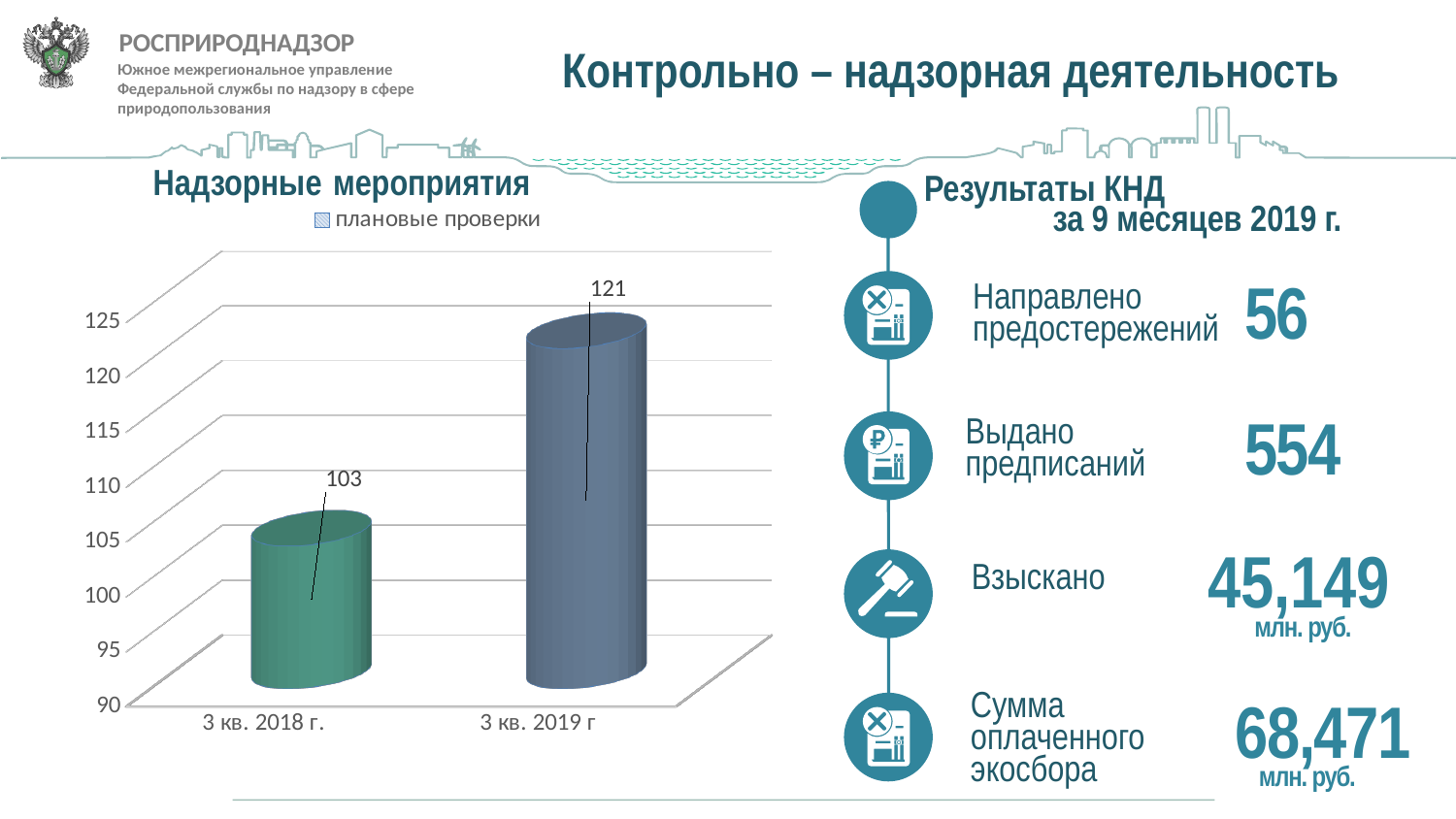
How many series does the chart legend list? 1 Which category has the lowest value in the chart? 3 кв. 2018 г. What is the value for 3 кв. 2019 г in the chart? 121 Which is larger: the value for 3 кв. 2018 г. or the value for 3 кв. 2019 г? 3 кв. 2019 г Is the value for 3 кв. 2018 г. greater or less than 110? less Is the value for 3 кв. 2019 г greater or less than 115? greater Which category has the highest value in the chart? 3 кв. 2019 г How many categories are shown on the x axis of the chart? 2 What kind of chart is shown on the slide? bar chart What is the value for 3 кв. 2018 г. in the chart? 103 What is the name of the series shown in the chart legend? плановые проверки What is the difference between the values for 3 кв. 2019 г and 3 кв. 2018 г.? 18